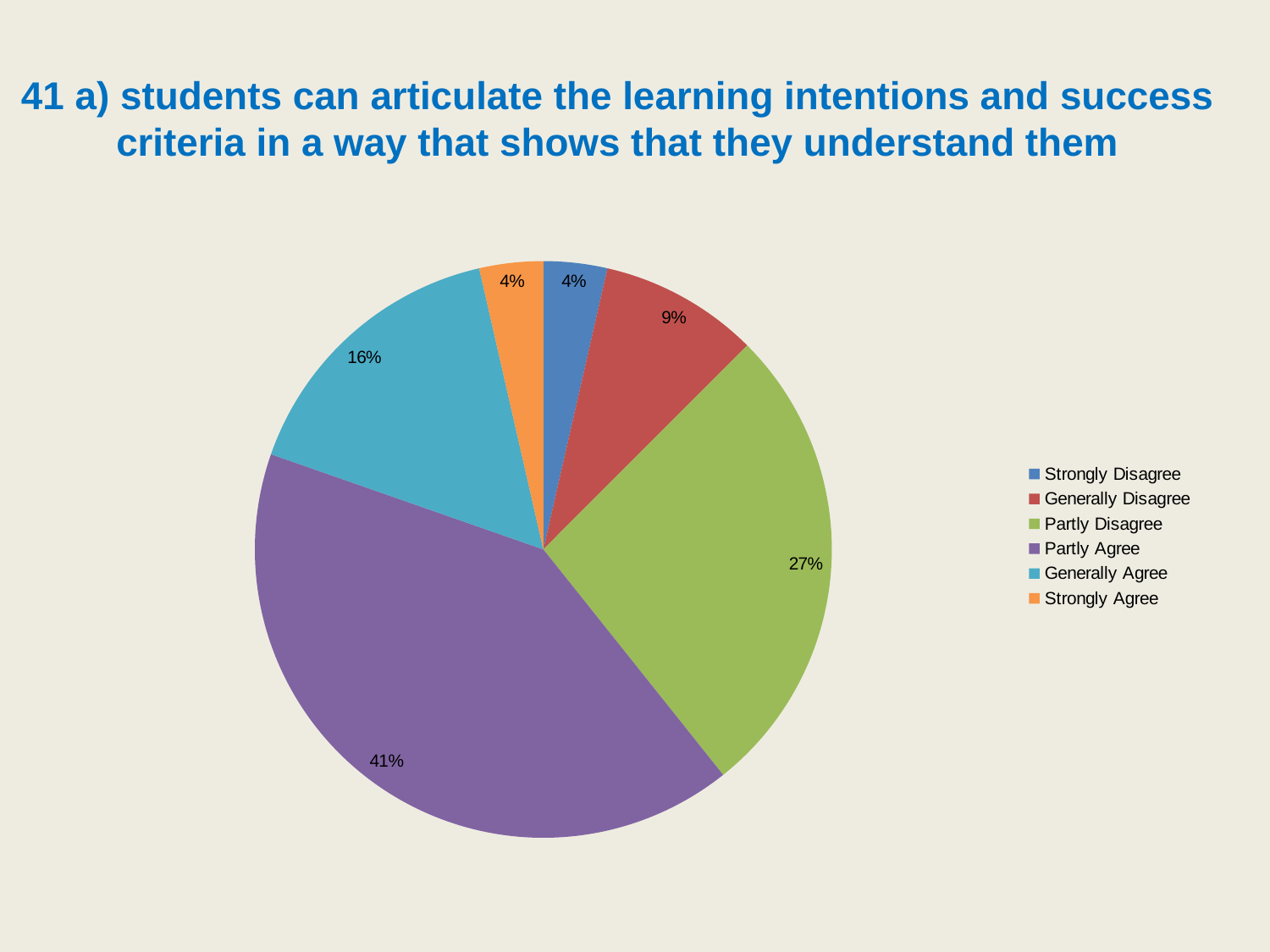
What share of the pie is Generally Disagree? 9% What share of the pie is Partly Agree? 41% What is the difference between the Generally Agree and Strongly Agree shares? 12% Which category has the largest slice of the pie? Partly Agree What share of the pie is Partly Disagree? 27% How many categories does the legend list? 6 What colour is the Partly Agree slice? purple Which is larger, the Generally Agree slice or the Generally Disagree slice? Generally Agree What is the difference between the Partly Agree and Partly Disagree shares? 14% What kind of chart is shown on the slide? pie chart Which legend entry is listed first? Strongly Disagree